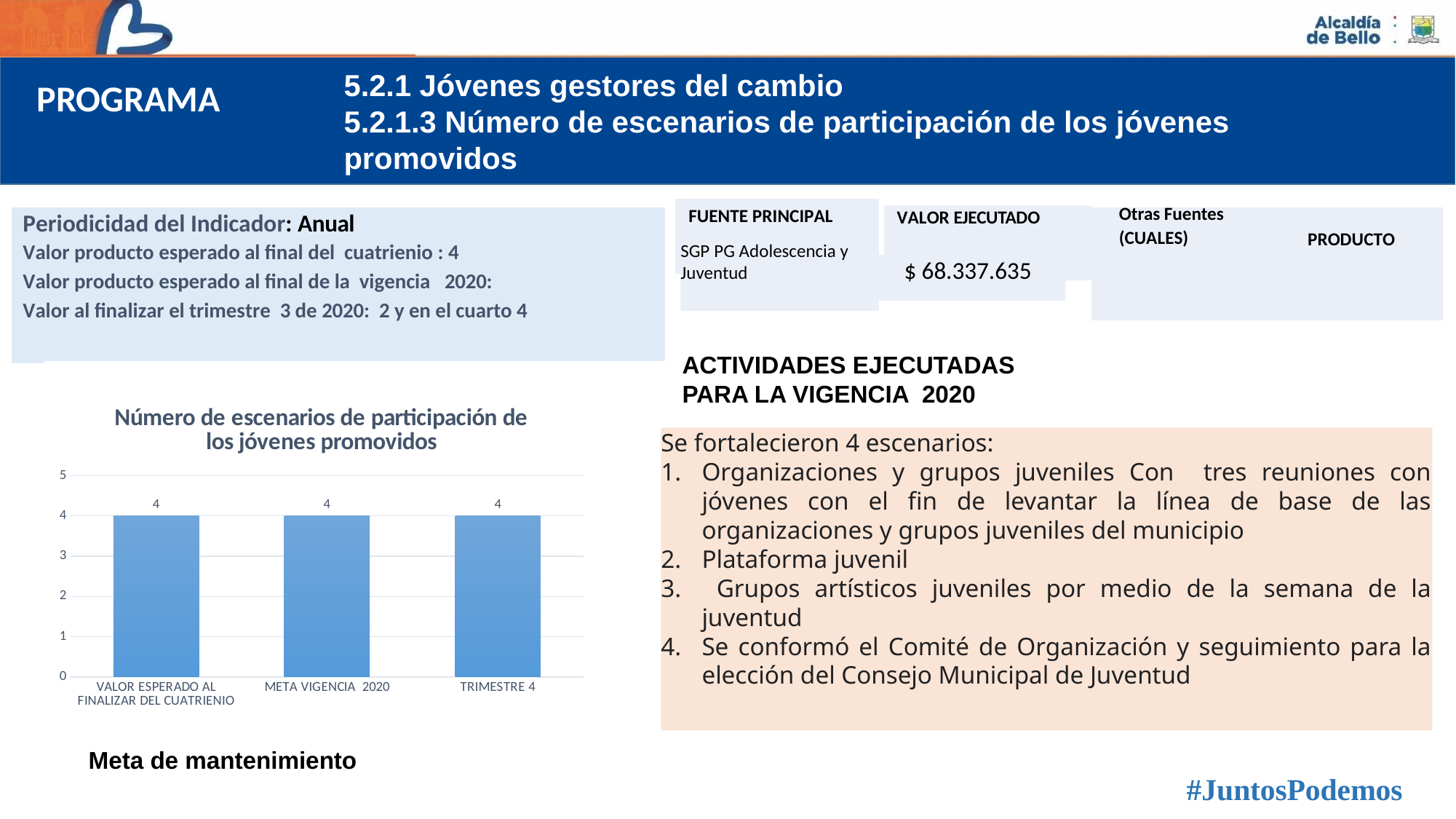
Is the value for META VIGENCIA 2020 greater or less than 5? less What is the value for TRIMESTRE 4 in the chart? 4 Do the values rise, fall or stay the same across the categories from left to right? stay the same What is the difference between the value for TRIMESTRE 4 and the value for META VIGENCIA 2020? 0 What kind of chart is shown on the slide? bar chart What is the highest value shown on the chart's y axis? 5 What is the value for META VIGENCIA 2020 in the chart? 4 What is the value for VALOR ESPERADO AL FINALIZAR DEL CUATRIENIO in the chart? 4 Is the value for TRIMESTRE 4 greater or less than 3? greater How many categories are shown on the x axis of the chart? 3 What is the title of the chart? Número de escenarios de participación de los jóvenes promovidos